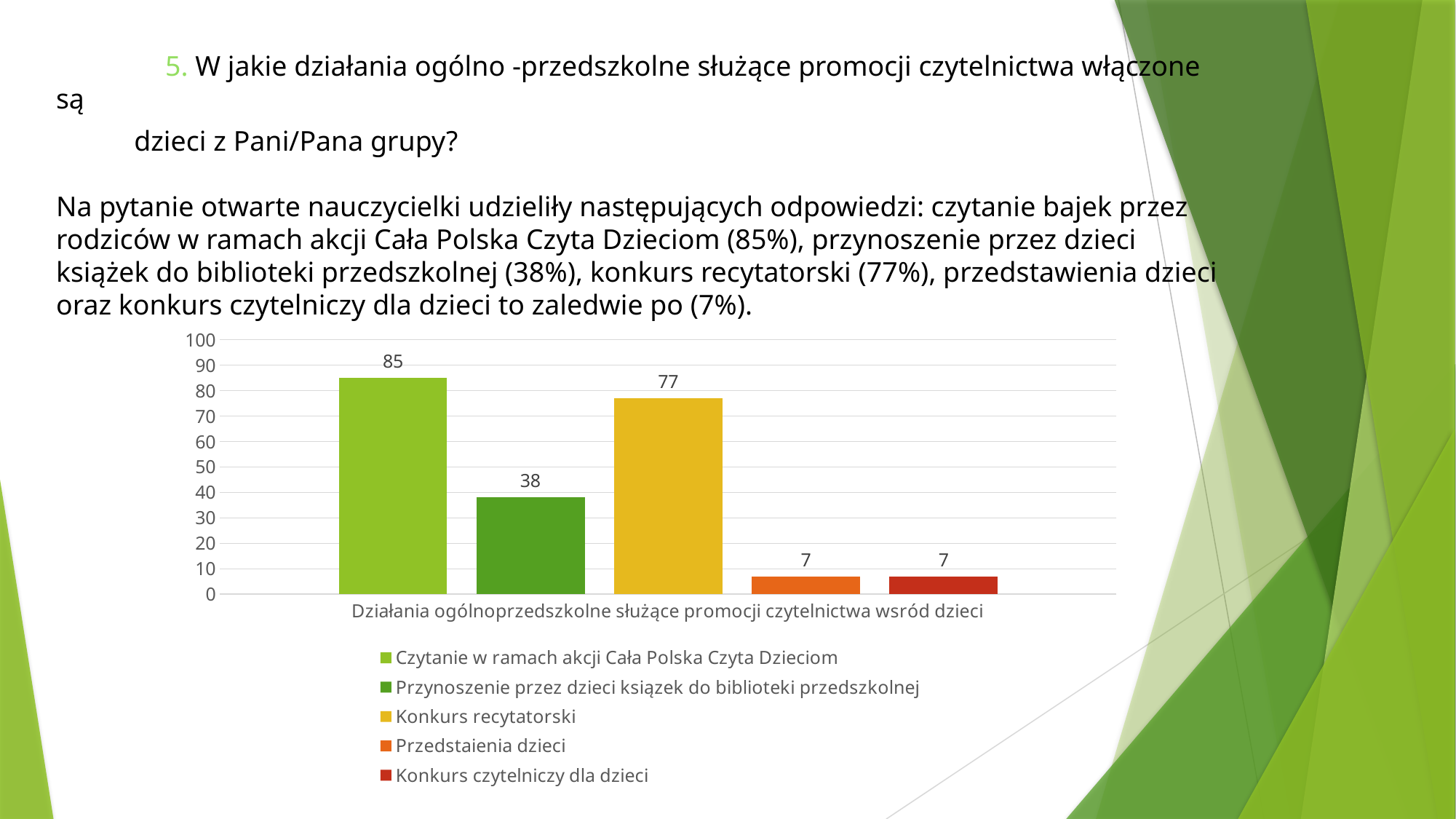
What colour is the bar for Konkurs recytatorski? yellow Is the value for Przynoszenie przez dzieci ksiązek do biblioteki przedszkolnej greater or less than 50? less What is the value for Przynoszenie przez dzieci ksiązek do biblioteki przedszkolnej? 38 What is the difference between the values for Konkurs recytatorski and Przynoszenie przez dzieci ksiązek do biblioteki przedszkolnej? 39 What is the value for Czytanie w ramach akcji Cała Polska Czyta Dzieciom? 85 What is the value for Konkurs recytatorski? 77 What is the difference between the values for Czytanie w ramach akcji Cała Polska Czyta Dzieciom and Konkurs recytatorski? 8 How many series does the legend list? 5 What is the value for Przedstaienia dzieci? 7 What kind of chart is shown on the slide? bar chart Which is larger, the value for Konkurs recytatorski or the value for Przynoszenie przez dzieci ksiązek do biblioteki przedszkolnej? Konkurs recytatorski Which series has the highest value? Czytanie w ramach akcji Cała Polska Czyta Dzieciom